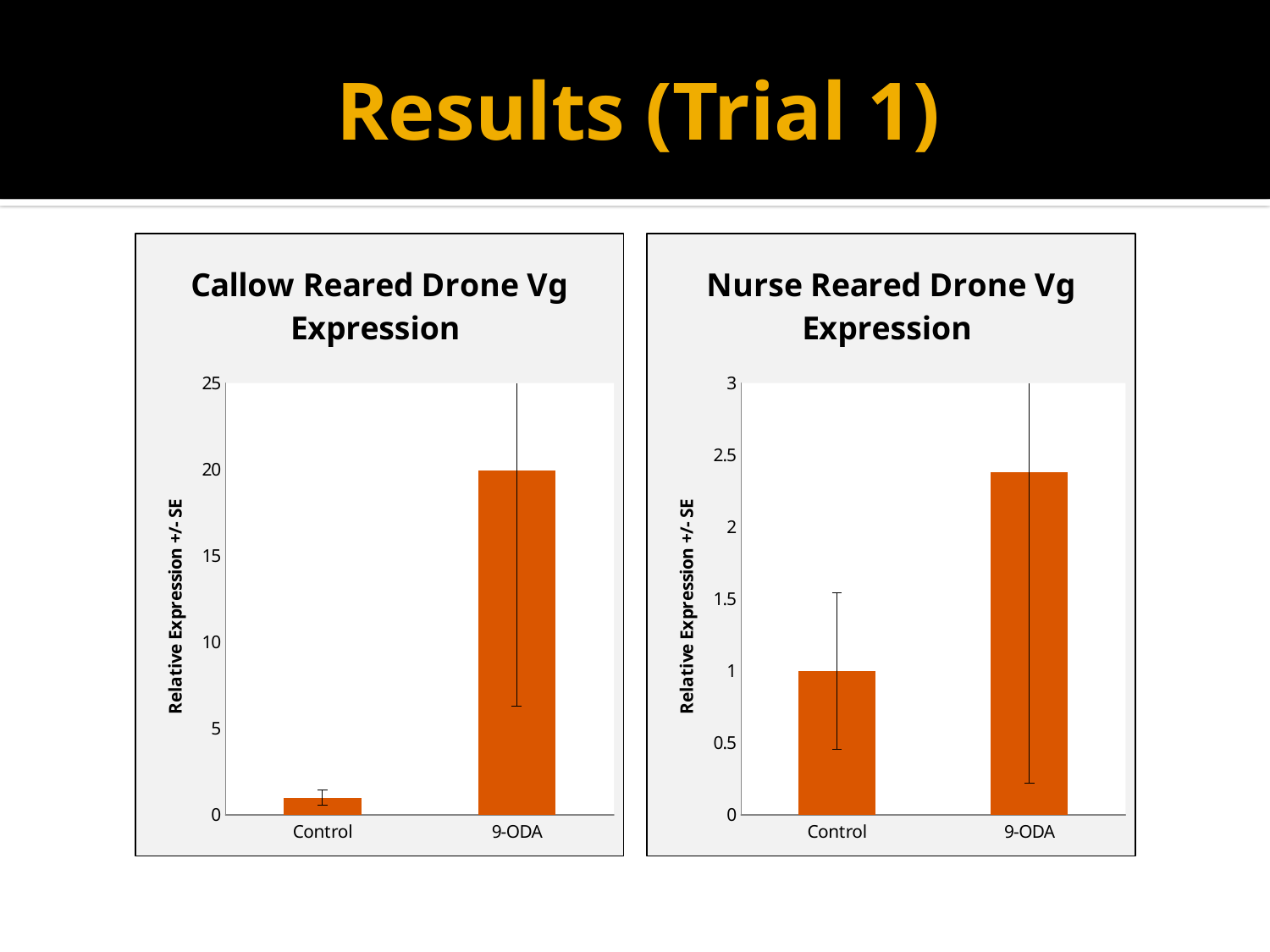
How many categories are shown on the x axis of the Nurse Reared Drone Vg Expression chart? 2 In the Callow Reared Drone Vg Expression chart, which category has the highest value? 9-ODA What is the title of the chart on the left side of the slide? Callow Reared Drone Vg Expression In the Callow Reared Drone Vg Expression chart, is the value for 9-ODA greater or less than 15? greater In the Callow Reared Drone Vg Expression chart, is the value for Control greater or less than 5? less In the Nurse Reared Drone Vg Expression chart, what is the value for Control? 1 In the Nurse Reared Drone Vg Expression chart, which is larger, the value for Control or the value for 9-ODA? 9-ODA What is the maximum value shown on the y axis of the Callow Reared Drone Vg Expression chart? 25 In the Nurse Reared Drone Vg Expression chart, which category has the lowest value? Control In the Nurse Reared Drone Vg Expression chart, is the value for 9-ODA greater or less than 2? greater What is the y-axis label of the Nurse Reared Drone Vg Expression chart? Relative Expression +/- SE What type of chart is the Callow Reared Drone Vg Expression chart? bar chart